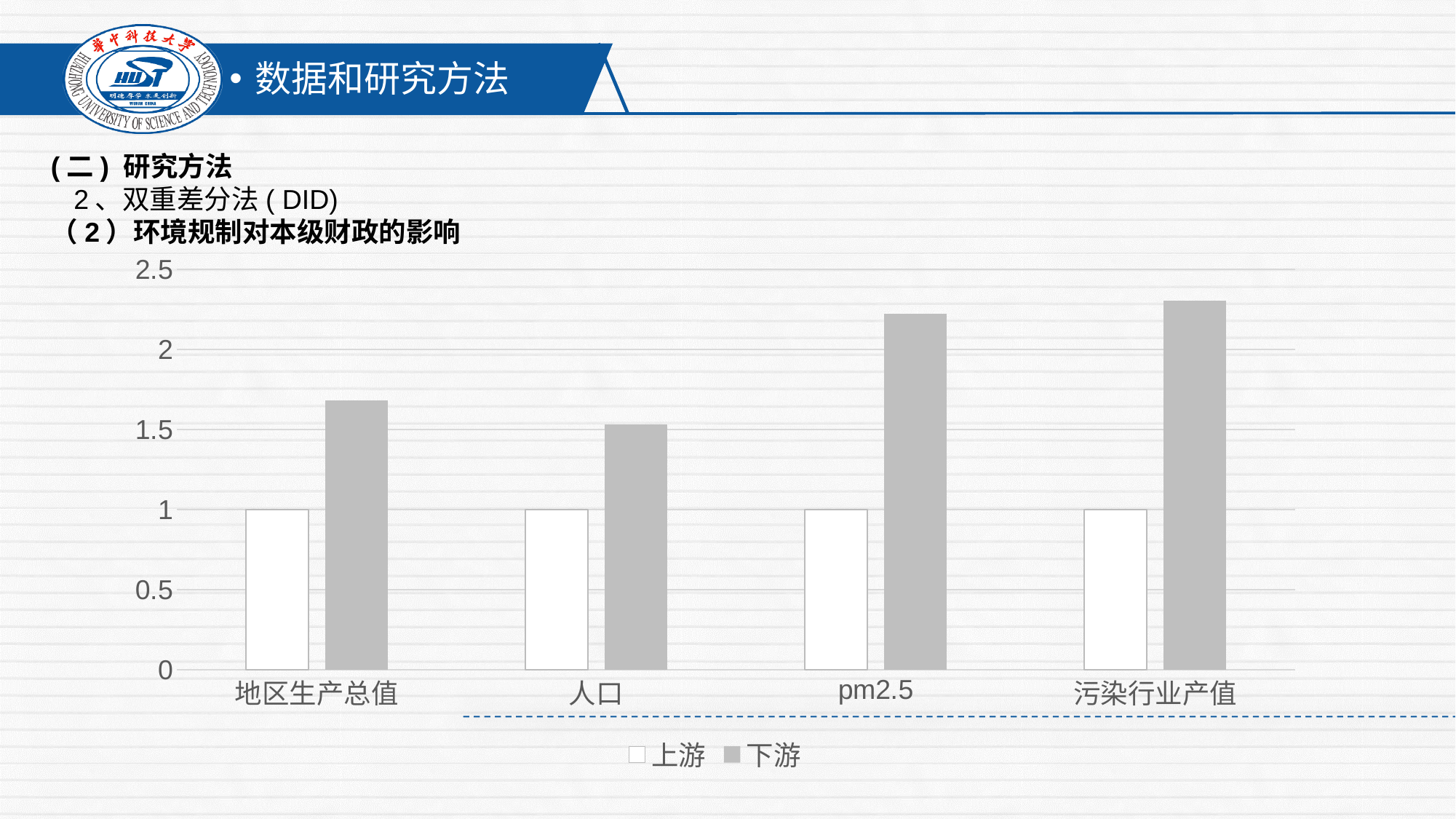
What are the two series names listed in the chart's legend? 上游 and 下游 Among the 下游 bars, which category has the lowest value? 人口 Is the 下游 value for 地区生产总值 greater or less than 2? less How many series does the chart's legend list? 2 Among the 下游 bars, which category has the highest value? 污染行业产值 What is the value of 上游 for pm2.5? 1 How many categories are shown on the x axis of the chart? 4 What kind of chart is shown on the slide? bar chart What is the value of 上游 for 地区生产总值? 1 For 人口, which series has the larger value, 上游 or 下游? 下游 Is the 下游 value for 地区生产总值 greater or less than 1.5? greater Is the 下游 value for pm2.5 greater or less than 2? greater